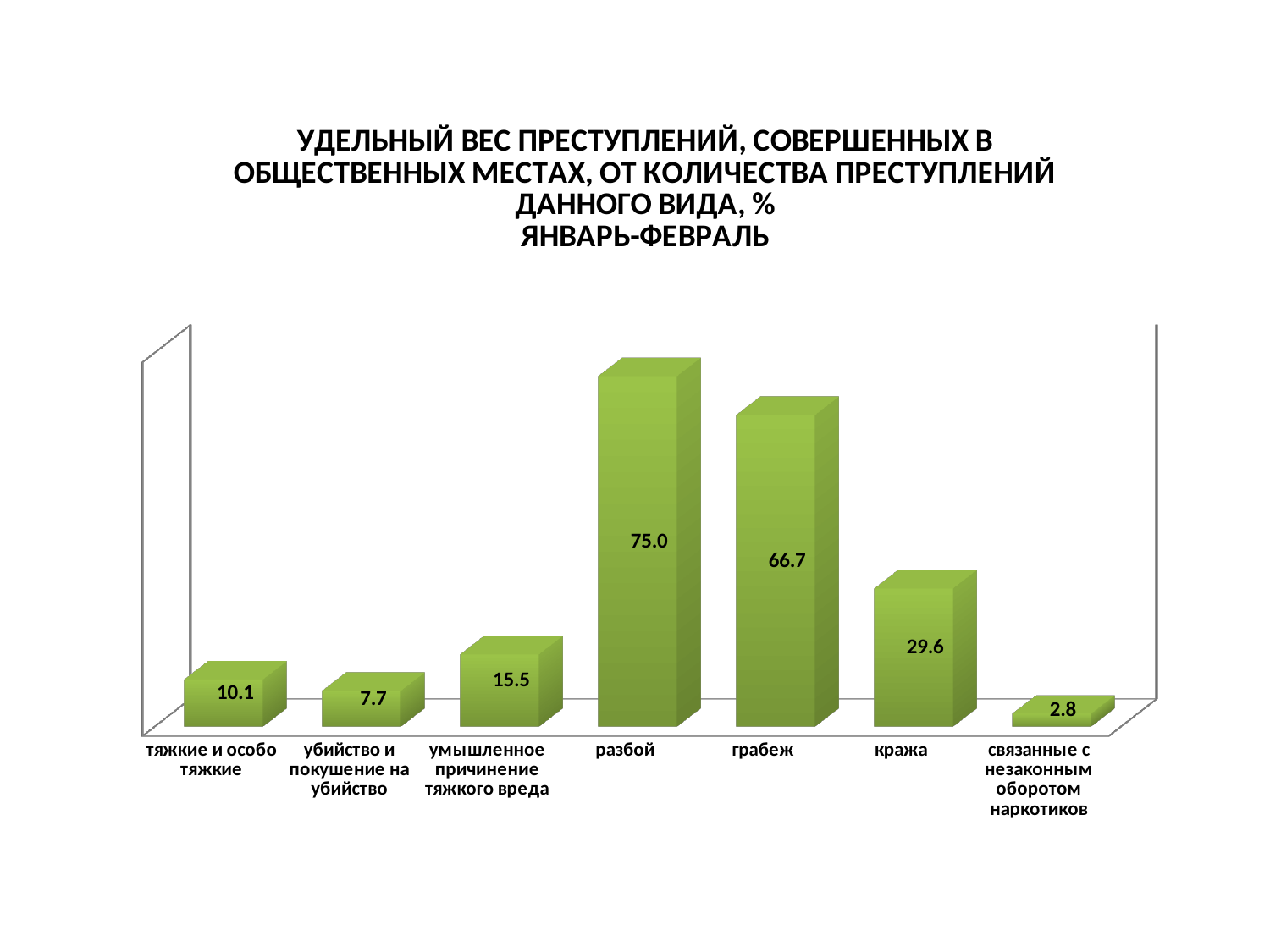
What is the value for кража? 29.6 What is the value for разбой? 75.0 What kind of chart is shown on the slide? bar chart What is the difference between the values for разбой and грабеж? 8.3 Which category has the lowest value? связанные с незаконным оборотом наркотиков What is the difference between the values for кража and тяжкие и особо тяжкие? 19.5 Which is larger, the value for умышленное причинение тяжкого вреда or the value for тяжкие и особо тяжкие? умышленное причинение тяжкого вреда What period does the chart title refer to? ЯНВАРЬ-ФЕВРАЛЬ Which category has the highest value? разбой What is the value for убийство и покушение на убийство? 7.7 What is the value for связанные с незаконным оборотом наркотиков? 2.8 How many categories are shown on the chart? 7